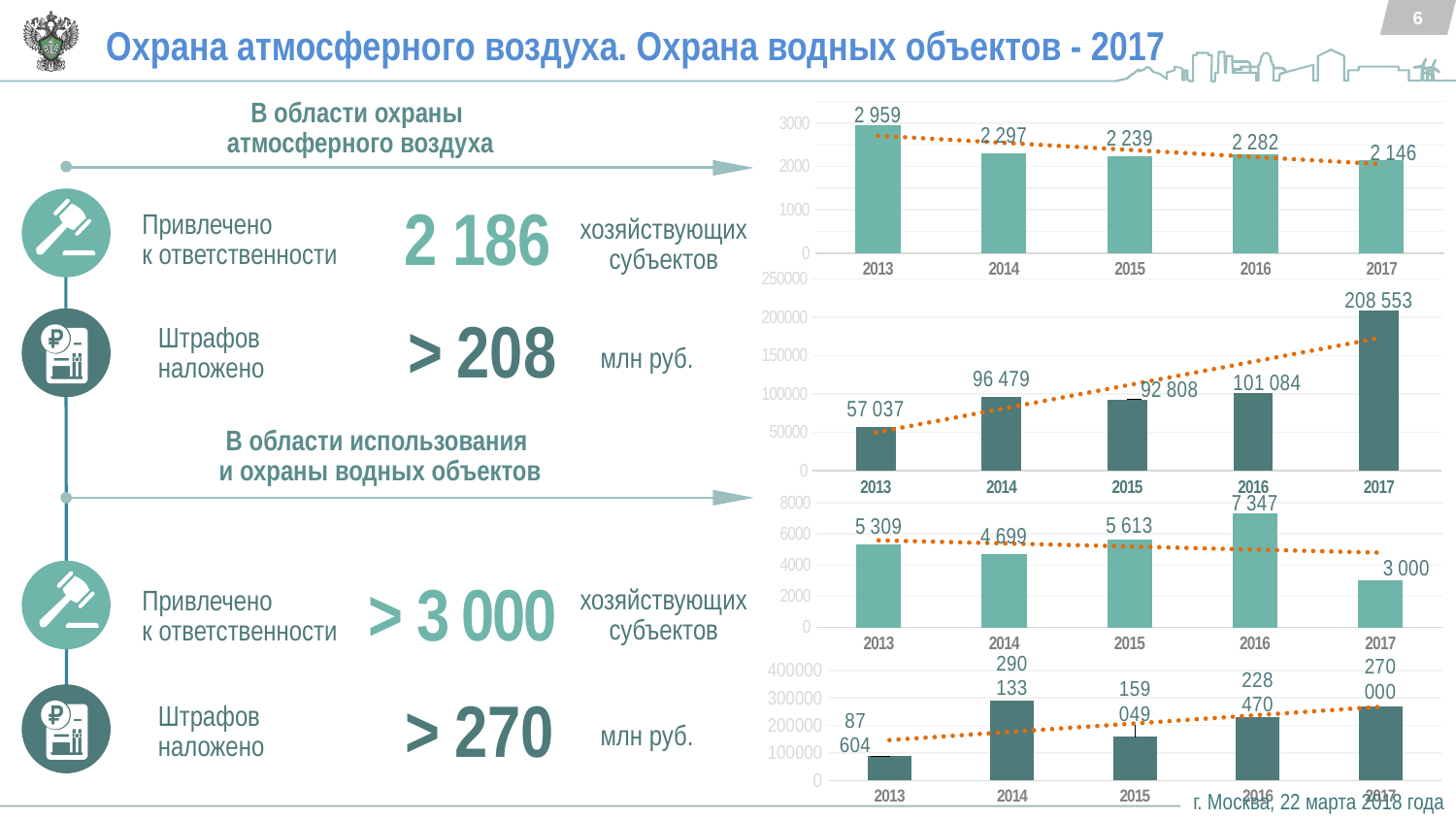
In the second chart from the top on the right, which year has the lowest value? 2013 In the third chart from the top on the right, what is the value for 2016? 7 347 In the top chart on the right, which year has the lowest value? 2017 In the top chart on the right, what is the value for 2013? 2 959 In the second chart from the top on the right, is the value for 2014 greater or less than 100000? less In the third chart from the top on the right, what is the difference between the values for 2016 and 2017? 4 347 In the second chart from the top on the right, what is the value for 2017? 208 553 How many years are shown on the x axis of the bottom chart on the right? 5 In the third chart from the top on the right, which is larger, the value for 2014 or the value for 2015? 2015 In the bottom chart on the right, which year has the highest value? 2014 In the bottom chart on the right, what is the value for 2014? 290 133 In the top chart on the right, what is the difference between the values for 2013 and 2017? 813